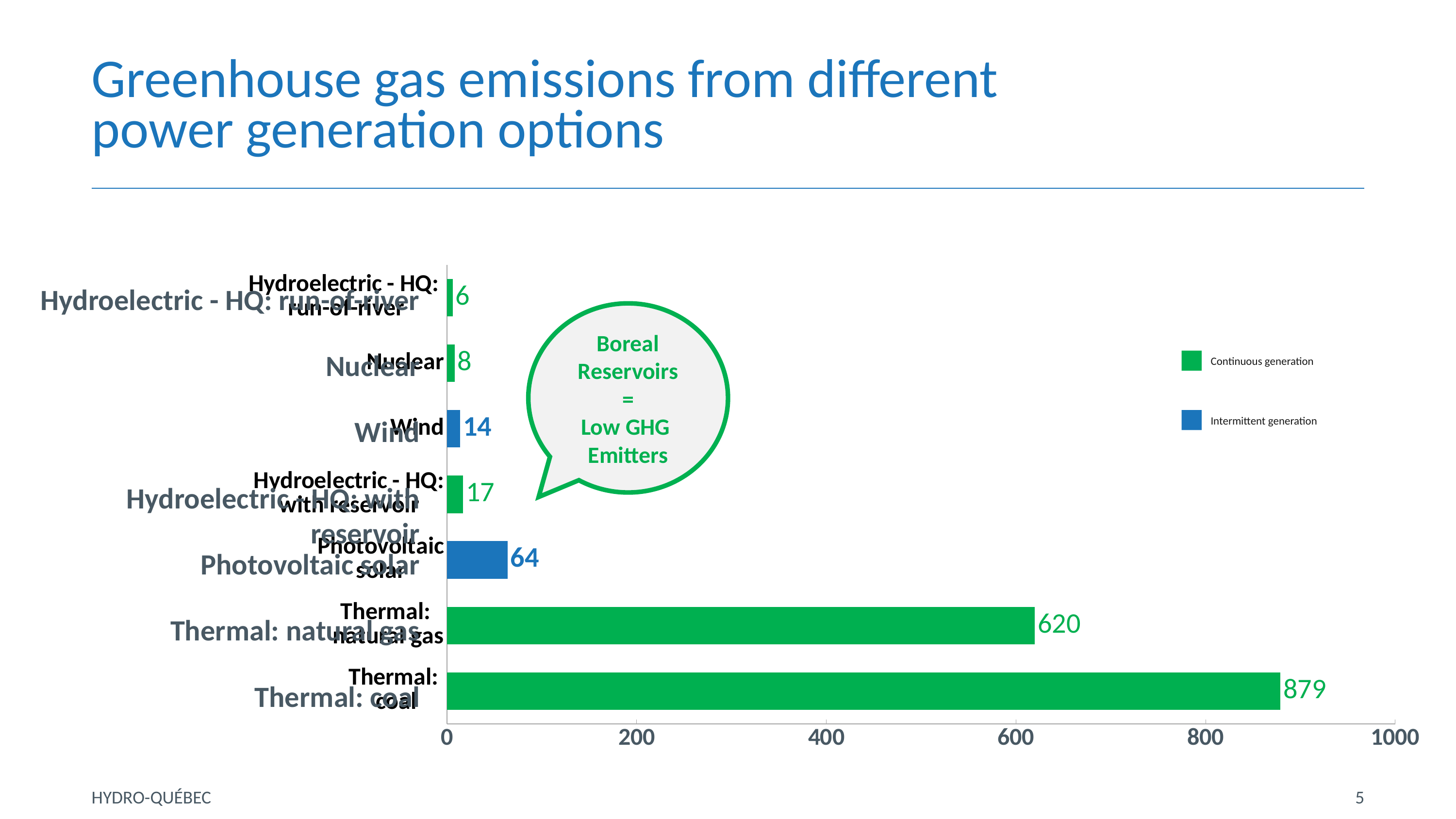
Which category has the lowest value? Hydroelectric - HQ: run-of-river What is the value for Thermal: coal? 879 What is the value for Wind? 14 What kind of chart is shown on the slide? bar chart What is the value for Photovoltaic solar? 64 Which category has the highest value? Thermal: coal What is the value for Hydroelectric - HQ: with reservoir? 17 Is the value for Thermal: natural gas greater or less than 400? greater Which is larger, the value for Nuclear or the value for Wind? Wind What is the difference between the values for Thermal: coal and Thermal: natural gas? 259 How many categories are shown in the chart? 7 How many series does the legend list? 2